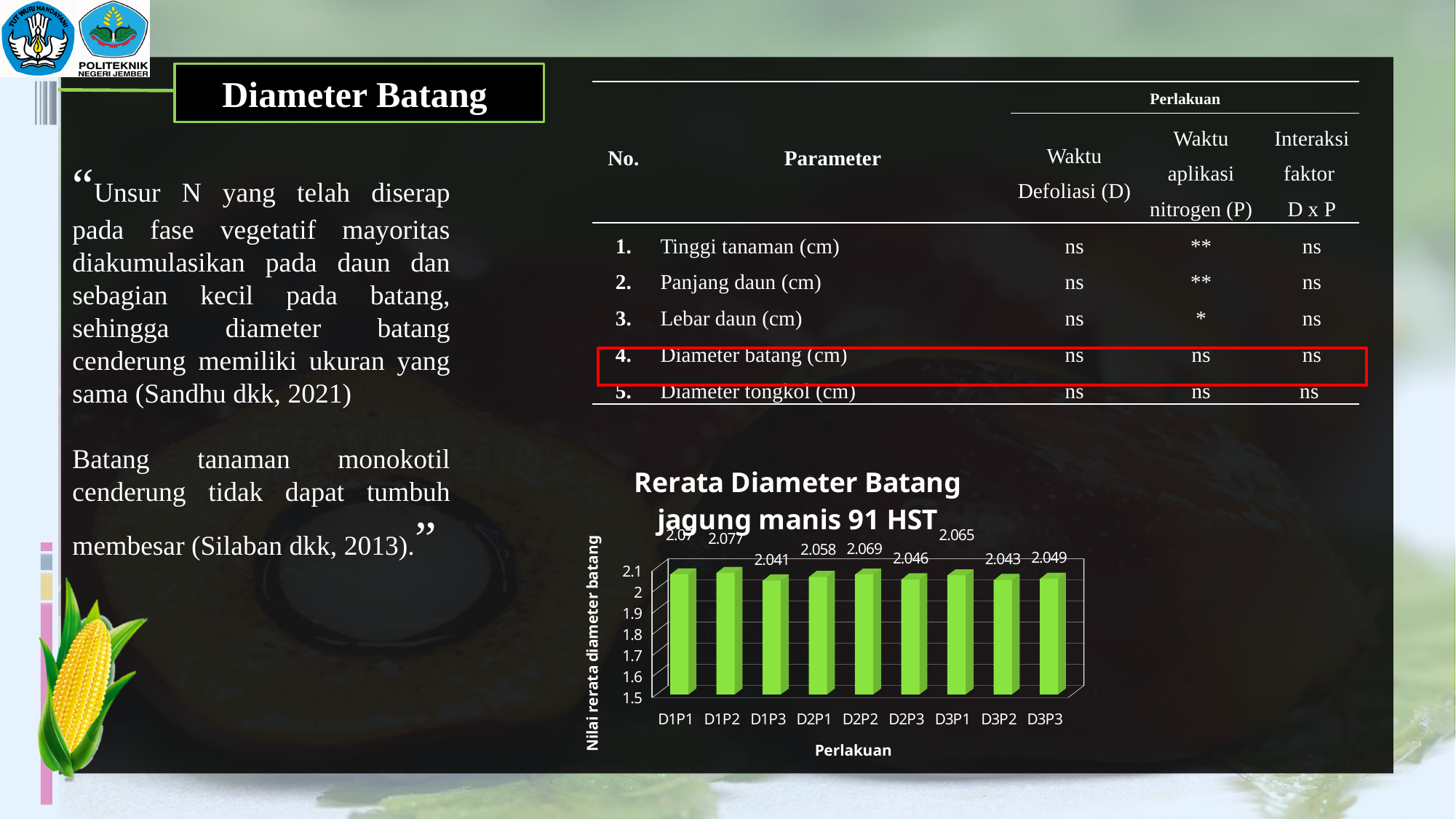
What is the difference between the values for D1P2 and D1P3? 0.036 How many treatments are shown on the x axis of the chart? 9 Which treatment has the highest value in the chart? D1P2 Is the value for D3P3 greater or less than 2? greater What is the value for D1P1 in the chart? 2.07 Which treatment has the lowest value in the chart? D1P3 Which is larger, the value for D2P1 or the value for D2P3? D2P1 What is the label of the x axis of the chart? Perlakuan What is the value for D2P2 in the chart? 2.069 What type of chart is shown on the slide? bar chart What is the title of the chart? Rerata Diameter Batang jagung manis 91 HST What is the value for D3P2 in the chart? 2.043